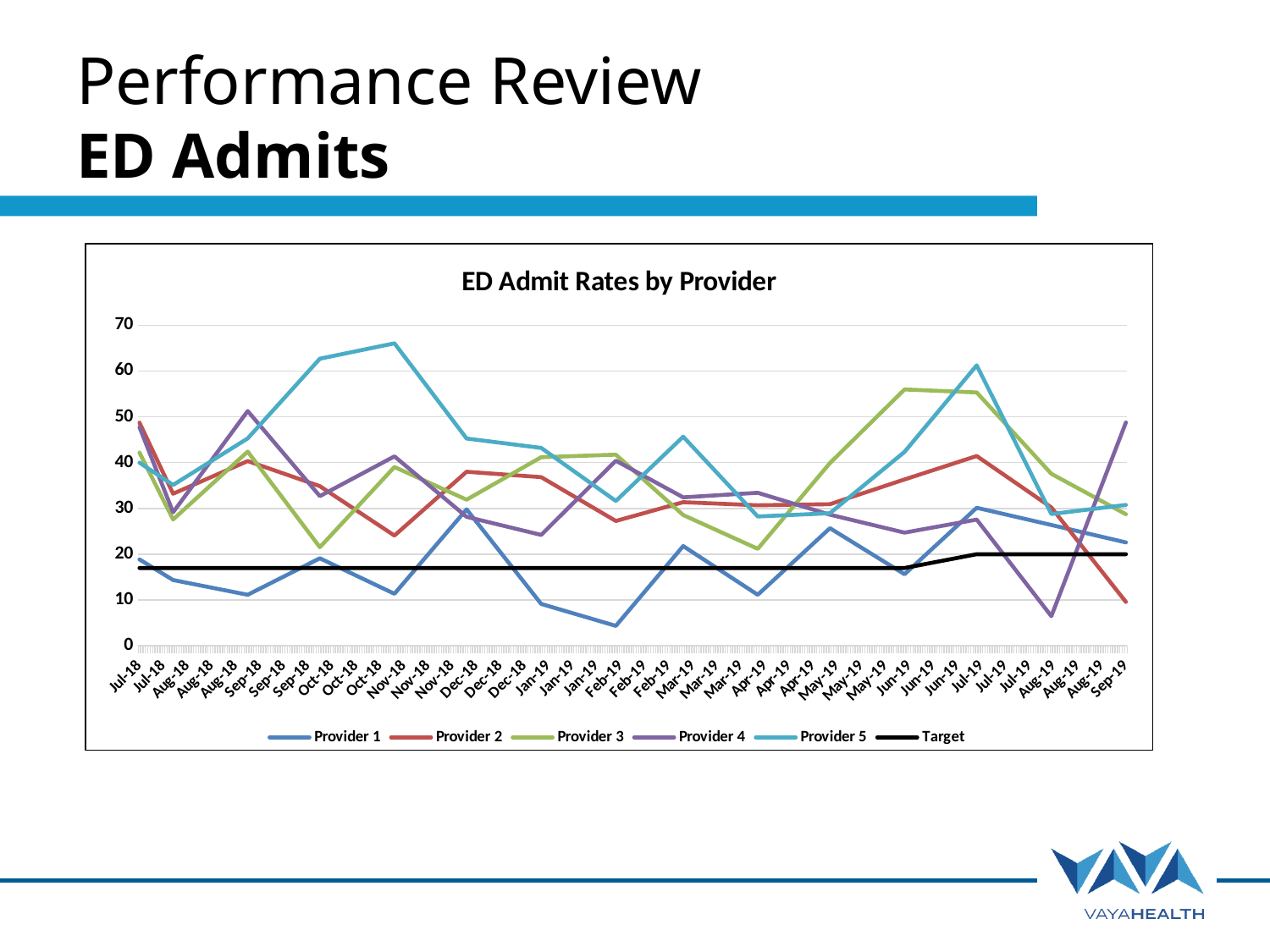
Is the value for Provider 2 at Jul-18 greater or less than 40? greater What kind of chart is shown on the slide? line chart Is the value for Provider 3 at Jun-19 greater or less than 50? greater Which series reaches the highest value anywhere on the chart? Provider 5 Is the value for Provider 1 at Feb-19 greater or less than 10? less What is the title of the chart? ED Admit Rates by Provider At Nov-18, which is larger: Provider 5 or Provider 1? Provider 5 At Sep-19, which is larger: Provider 4 or Provider 2? Provider 4 How many series does the legend list? 6 What colour is the Target line? black